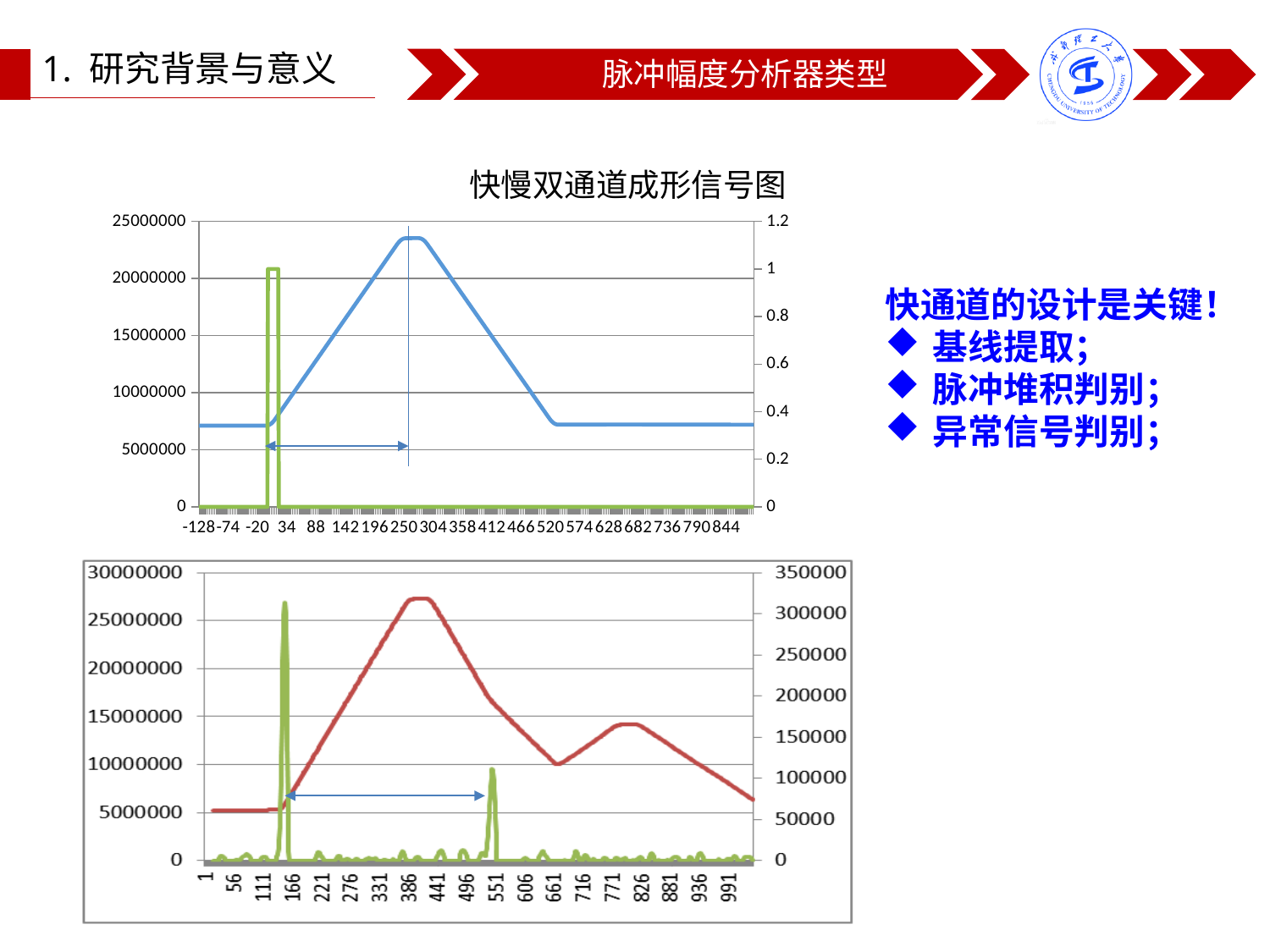
In the bottom chart, is the second peak of the green line (near 551) greater or less than 150000 on the right axis? less In the top chart, is the peak of the blue line greater or less than 20000000 on the left axis? greater In the top chart, is the peak of the green pulse greater or less than 0.8 on the right axis? greater What is the maximum value shown on the right axis of the top chart? 1.2 In the top chart, how many lines are plotted? 2 What is the title of the top chart? 快慢双通道成形信号图 What kind of chart is the bottom chart? line chart In the bottom chart, which peak of the red line is higher, the first one (near 386–441) or the second one (near 771)? the first one What kind of chart is the top chart titled 快慢双通道成形信号图? line chart